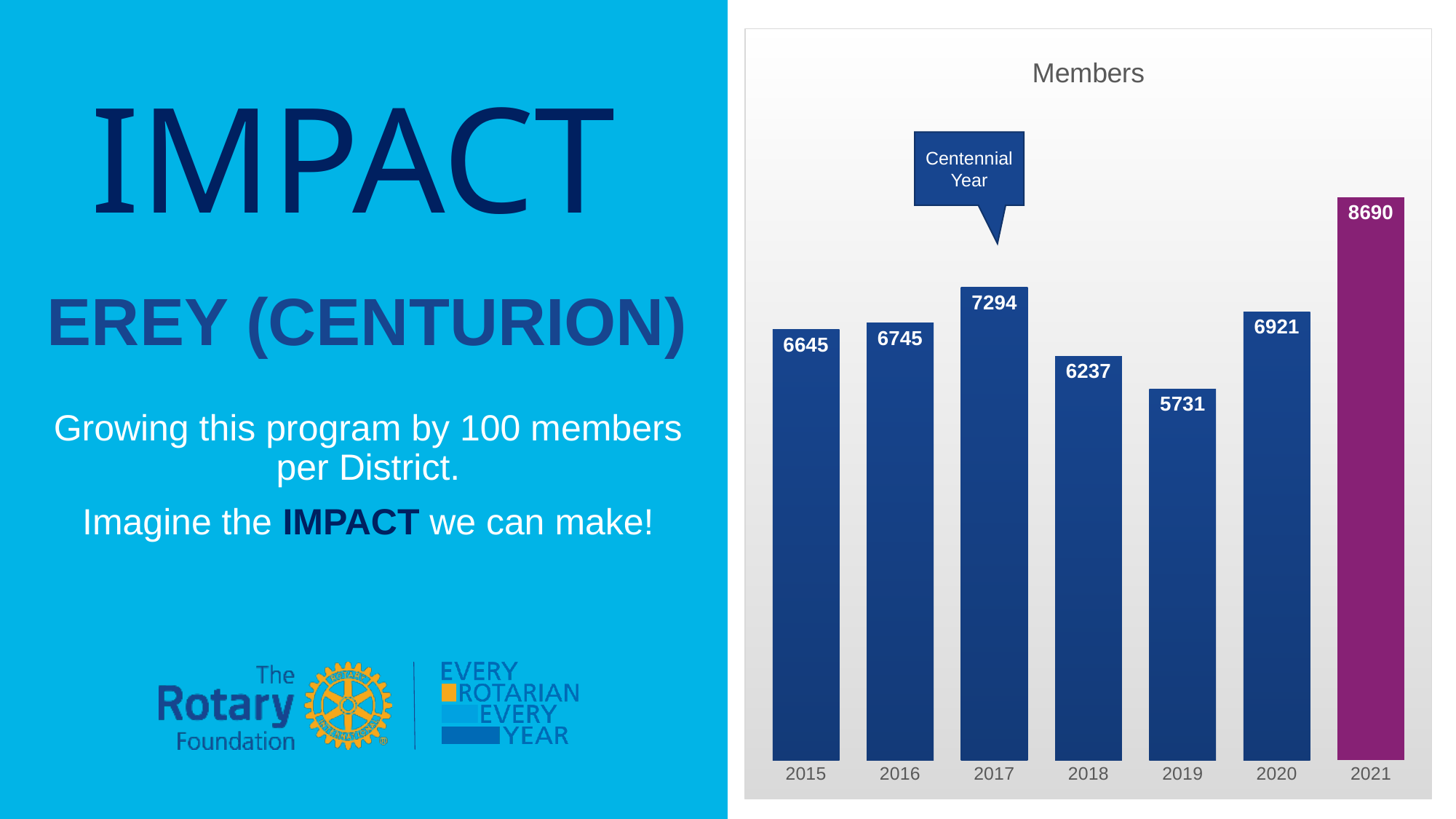
What is the number of members in 2019? 5731 What is the number of members in 2021? 8690 Do the member numbers rise or fall from 2017 to 2019? Fall Which year has the highest number of members? 2021 What is the difference in members between 2017 and 2018? 1057 How many years are shown on the chart? 7 Which year has more members, 2016 or 2020? 2020 Which year has the lowest number of members? 2019 Which year is labelled as the Centennial Year on the chart? 2017 What is the difference in members between 2021 and 2020? 1769 What kind of chart is shown on the slide? Bar chart What is the number of members in 2017? 7294